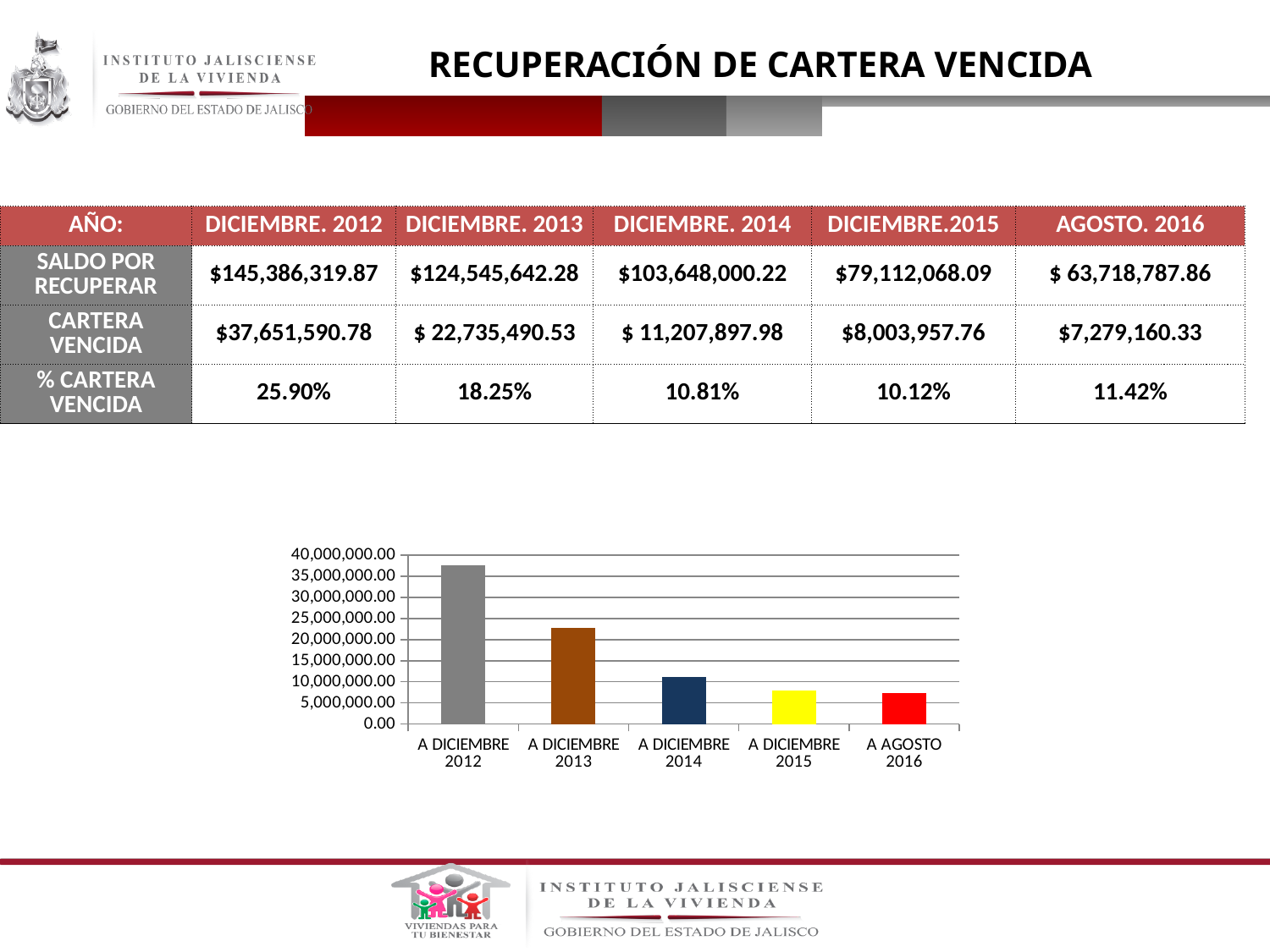
Is the bar for A DICIEMBRE 2012 greater or less than 35,000,000.00? greater According to the table, what is the CARTERA VENCIDA value plotted for DICIEMBRE 2012? $37,651,590.78 Do the bar values rise or fall from A DICIEMBRE 2012 to A DICIEMBRE 2015? fall Is the bar for A DICIEMBRE 2013 greater or less than 20,000,000.00? greater How many bars (categories) does the chart show? 5 Which category has the highest bar in the chart? A DICIEMBRE 2012 What is the highest value shown on the chart's vertical axis? 40,000,000.00 Is the bar for A DICIEMBRE 2015 greater or less than 10,000,000.00? less According to the table, what is the CARTERA VENCIDA value plotted for AGOSTO 2016? $7,279,160.33 What kind of chart is shown on the slide? bar chart Which bar is taller, A DICIEMBRE 2013 or A DICIEMBRE 2014? A DICIEMBRE 2013